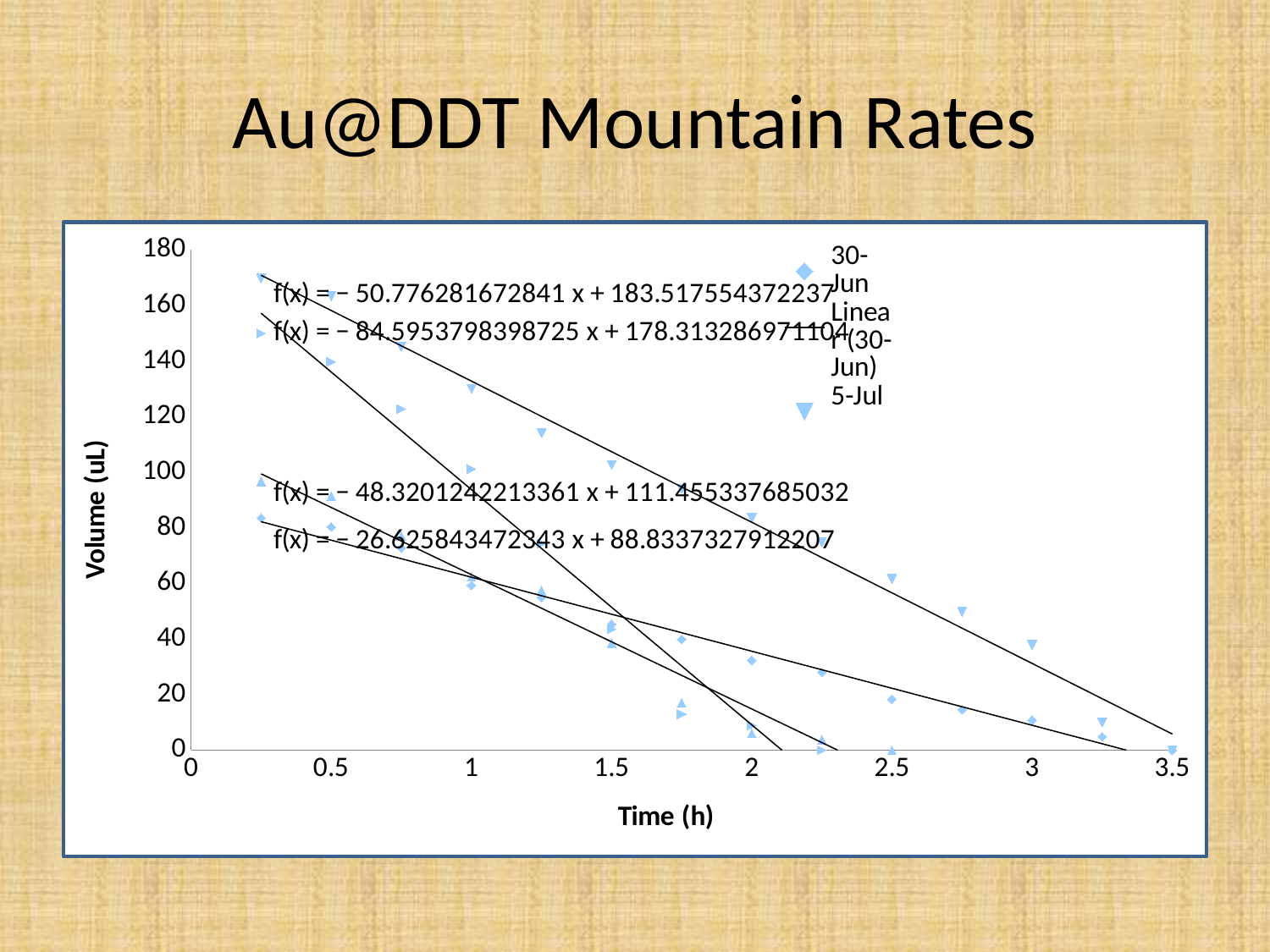
What is the title of the chart? Au@DDT Mountain Rates At time 0.25, which series has the larger volume, 30-Jun or 5-Jul? 5-Jul Is the value for 5-Jul at time 3.5 greater or less than 20? less Is the value for 5-Jul at time 2.5 greater or less than 40? greater Do the plotted volumes rise or fall as time increases along the x axis? fall Is the value for 5-Jul at time 0.25 greater or less than 160? greater What kind of chart is shown on the slide? scatter chart How many trendline equations are printed on the chart? 4 What is the intercept in the trendline equation f(x) = − 84.5953798398725 x + ...? 178.313286971104 At time 3, which series has the larger volume, 30-Jun or 5-Jul? 5-Jul